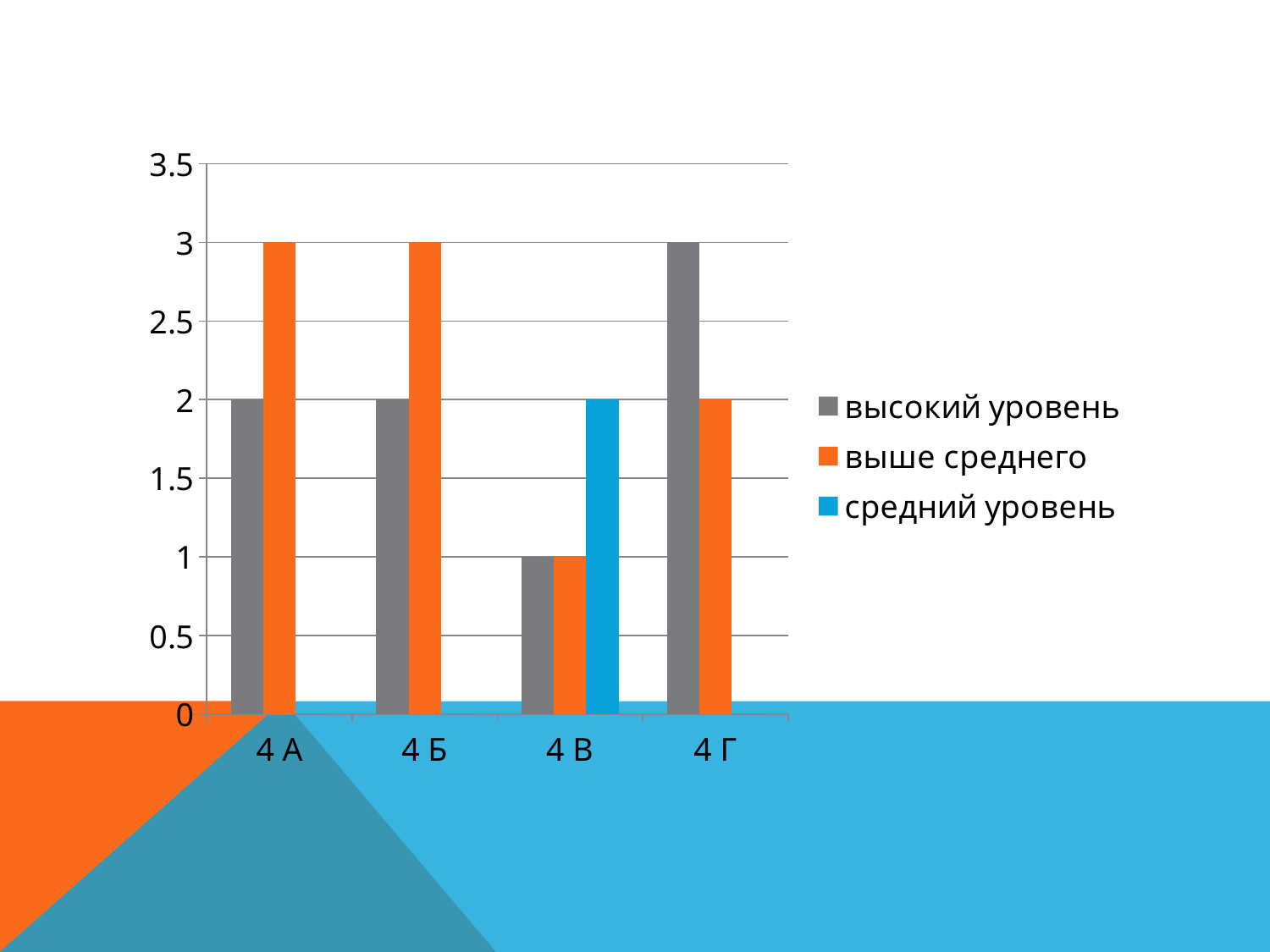
How many categories are shown on the x axis? 4 What is the value of 'высокий уровень' for 4 Г? 3 How many series does the legend list? 3 What kind of chart is shown on the slide? bar chart Which category has the highest value for 'высокий уровень'? 4 Г Which category has the lowest value for 'выше среднего'? 4 В What is the difference between 'выше среднего' and 'высокий уровень' for 4 Б? 1 What is the value of 'высокий уровень' for 4 В? 1 What is the value of 'средний уровень' for 4 В? 2 What is the value of 'выше среднего' for 4 А? 3 For 4 Г, which is larger: 'высокий уровень' or 'выше среднего'? высокий уровень Which category is the only one with a 'средний уровень' bar? 4 В